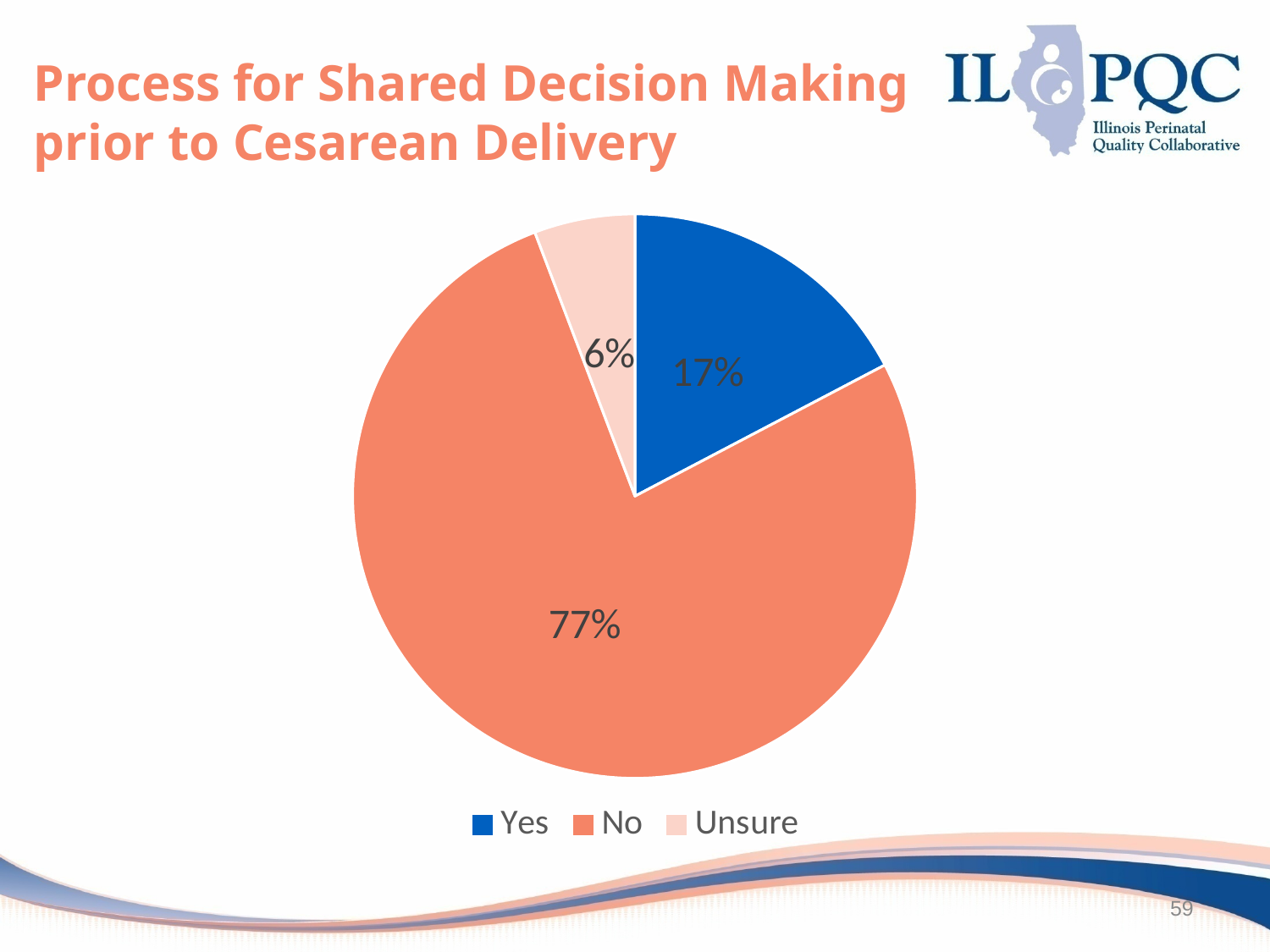
Which category has the largest slice of the pie? No Which slice is larger, "Yes" or "Unsure"? Yes What kind of chart is shown on the slide? pie chart Which category has the smallest slice of the pie? Unsure What percentage of the pie is labelled "Yes"? 17% What colour is the "Yes" slice of the pie? blue What is the title of the slide containing the pie chart? Process for Shared Decision Making prior to Cesarean Delivery What is the difference in percentage points between the "Yes" slice and the "Unsure" slice? 11 What is the difference in percentage points between the "No" slice and the "Yes" slice? 60 What percentage of the pie is labelled "No"? 77% How many categories does the legend list? 3 What percentage of the pie is labelled "Unsure"? 6%